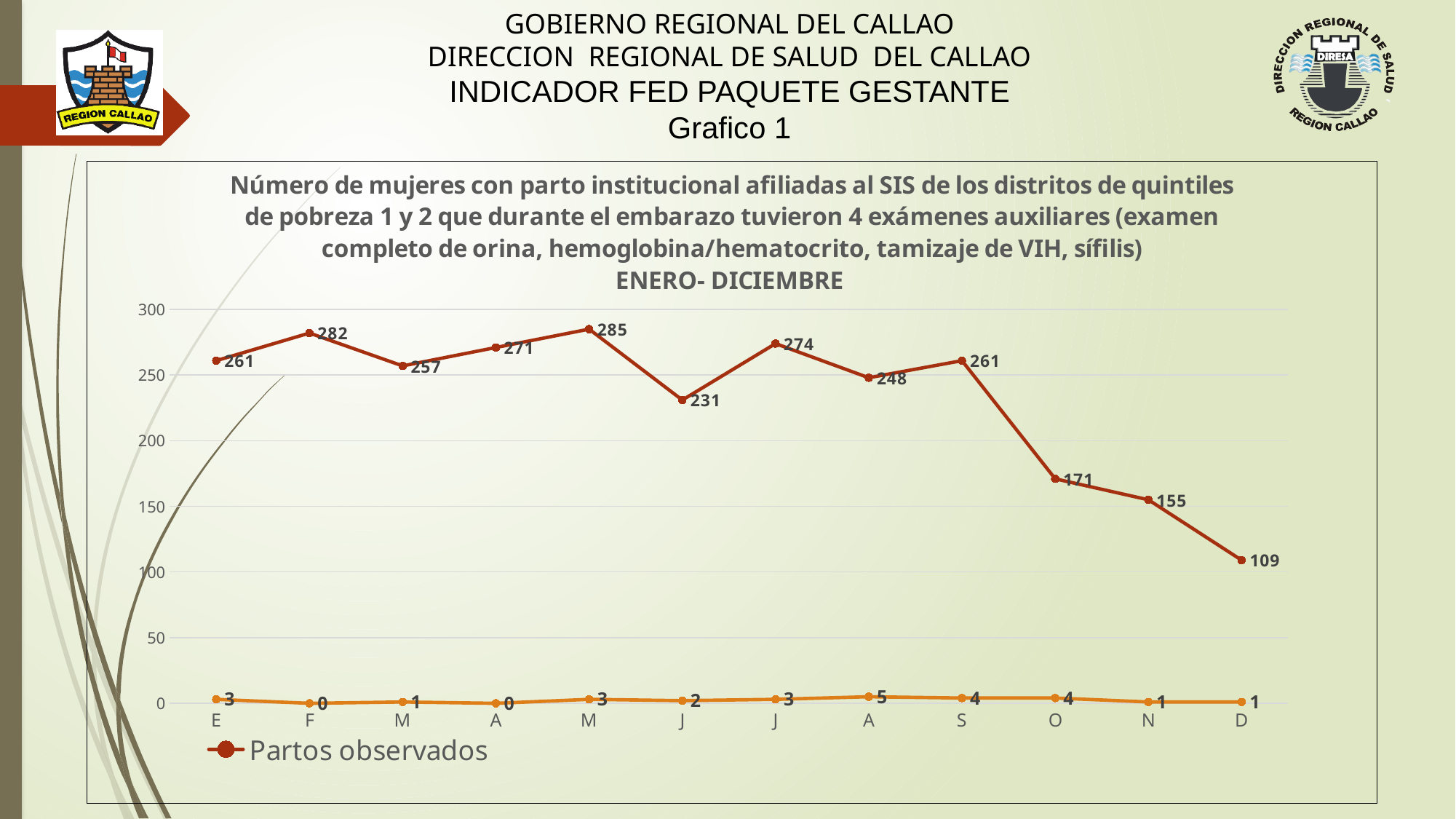
How many months are plotted on the x axis? 12 How many series does the legend list? 1 What is the value of Partos observados for E? 261 Which month has the highest value of Partos observados? the second M (285) Does the Partos observados line rise or fall from S to D? fall What is the difference between Partos observados for F and for N? 127 What is the value of Partos observados for D? 109 Is the value of Partos observados for N greater or less than 200? less What type of chart is shown on the slide? line chart What is the value of Partos observados for O? 171 Which month has the lowest value of Partos observados? D Which is larger, Partos observados for S or for O? S